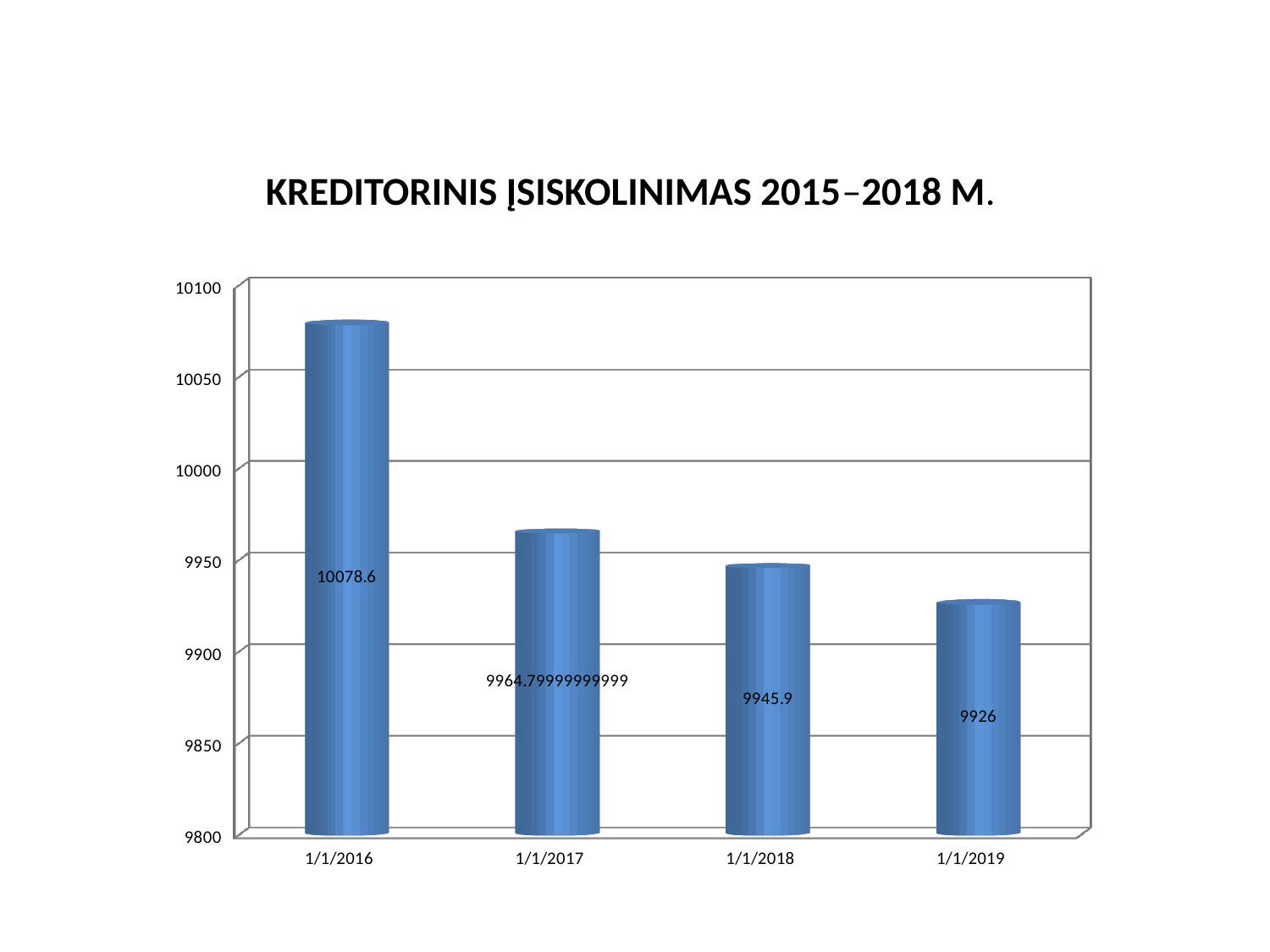
What is the value for 1/1/2019? 9926 Which is larger, the value for 1/1/2017 or the value for 1/1/2018? 1/1/2017 What is the difference between the values for 1/1/2016 and 1/1/2019? 152.6 What is the difference between the values for 1/1/2018 and 1/1/2019? 19.9 Which date has the highest value? 1/1/2016 What is the data label shown on the bar for 1/1/2017? 9964.79999999999 How many bars are shown in the chart? 4 What is the value for 1/1/2016? 10078.6 Is the value for 1/1/2016 greater or less than 10050? greater Which date has the lowest value? 1/1/2019 Do the values rise or fall from 1/1/2016 to 1/1/2019? fall What is the value for 1/1/2018? 9945.9